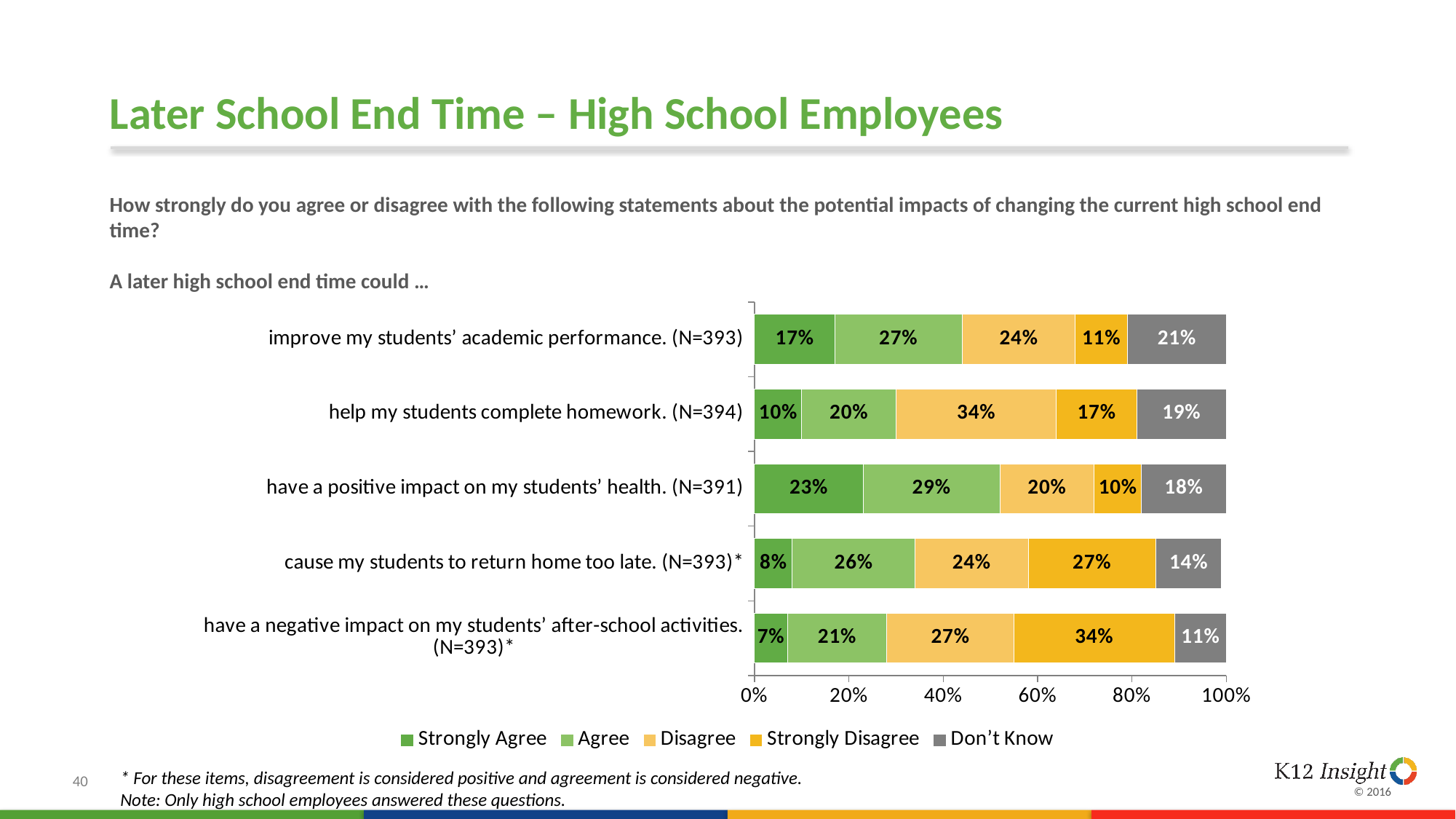
Which statement has the highest 'Strongly Agree' percentage? have a positive impact on my students' health. (N=391) What percentage of respondents answered 'Don't Know' for the statement about a positive impact on students' health? 18% Which statement has the lowest 'Don't Know' percentage? have a negative impact on my students' after-school activities. (N=393)* What percentage of high school employees strongly agree that a later end time could improve their students' academic performance? 17% Which is larger: the 'Strongly Disagree' share for 'cause my students to return home too late' or for 'improve my students' academic performance'? cause my students to return home too late What percentage strongly disagree that a later end time could have a negative impact on students' after-school activities? 34% What type of chart is shown on the slide? Stacked bar chart What is the difference between the 'Agree' percentages for the health statement and the homework statement? 9 percentage points What percentage of respondents disagree that a later end time could help their students complete homework? 34% How many response categories does the legend list? 5 What is the combined 'Strongly Agree' and 'Agree' percentage for the statement about students returning home too late? 34% How many statements are shown in the chart? 5